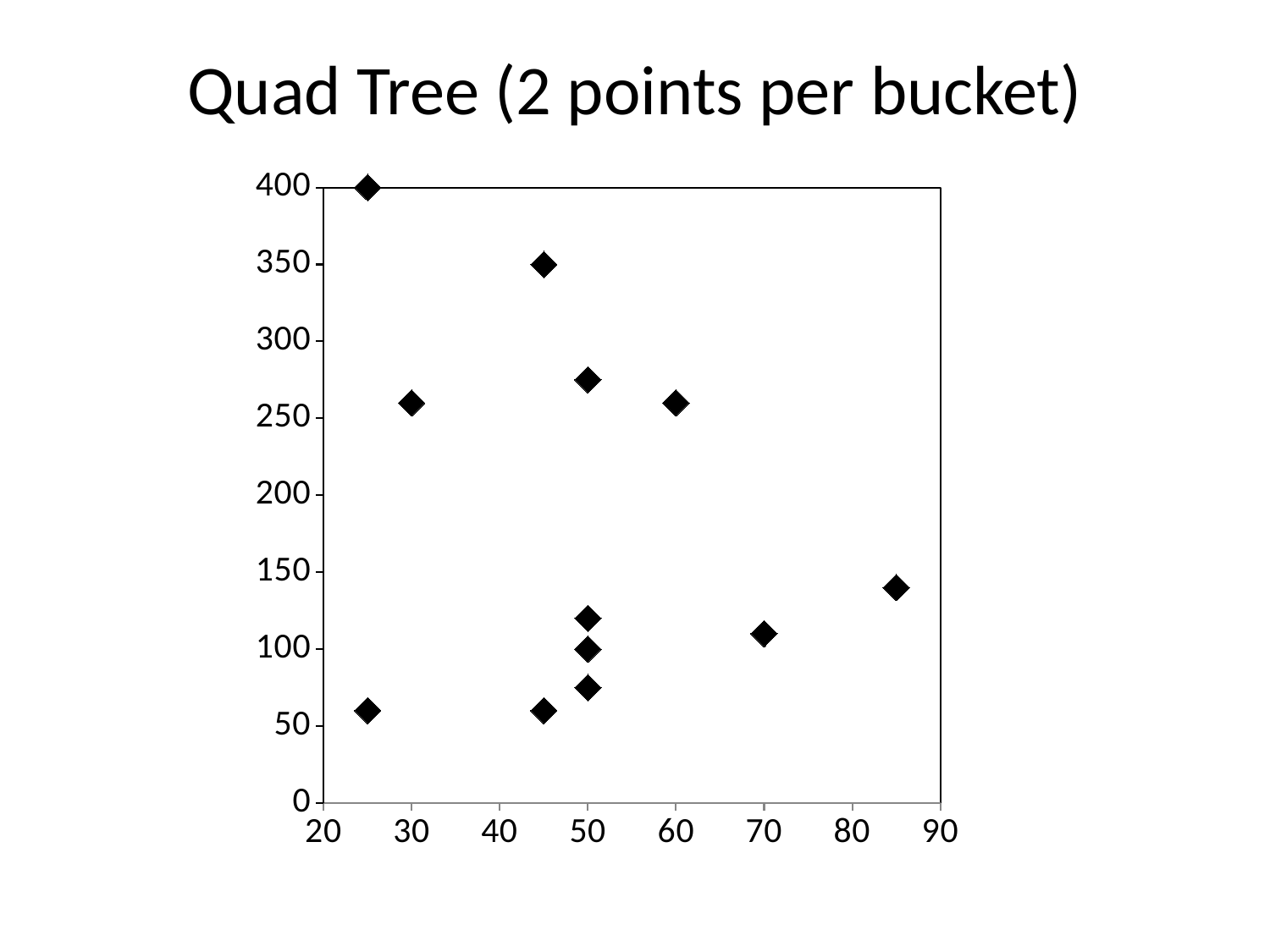
What kind of chart is shown on the slide? scatter chart What is the maximum value shown on the x axis? 90 What is the title of the chart? Quad Tree (2 points per bucket) How many points have a y value above 300? 2 Is the y value of the rightmost point (at x = 85) greater or less than 150? less How many data points are plotted on the chart? 12 Is the y value of the point at x = 45 near the top of the chart greater or less than 300? greater Is the y value of the point at x = 70 greater or less than 150? less Which point has the larger y value: the one at x = 70 or the one at x = 85? the one at x = 85 What is the y value of the highest point on the chart? 400 What is the x value of the point that lies exactly at y = 100? 50 How many points are plotted at x = 50? 4